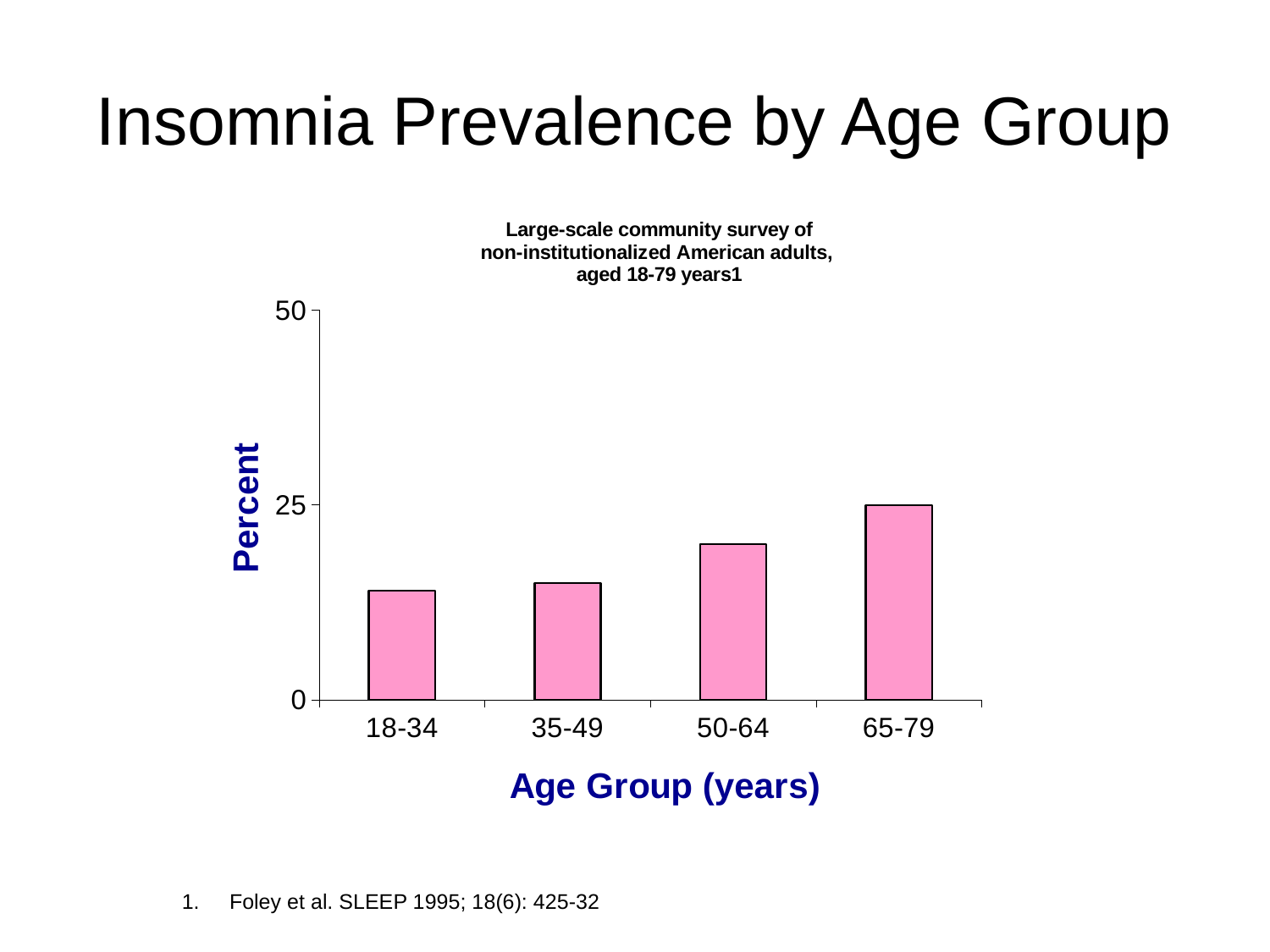
What is the label of the x axis of the chart? Age Group (years) Do the values in the chart rise or fall as age group increases along the x axis? rise Which has a higher value in the chart, the 50-64 age group or the 18-34 age group? 50-64 Which has a higher value in the chart, the 65-79 age group or the 35-49 age group? 65-79 Which age group has the highest insomnia prevalence in the chart? 65-79 What is the label of the y axis of the chart? Percent Is the value for the 18-34 age group greater or less than 25? less How many age groups are shown on the x axis of the chart? 4 Is the value for the 35-49 age group greater or less than 25? less What kind of chart is shown on the slide? bar chart Is the value for the 50-64 age group greater or less than 25? less